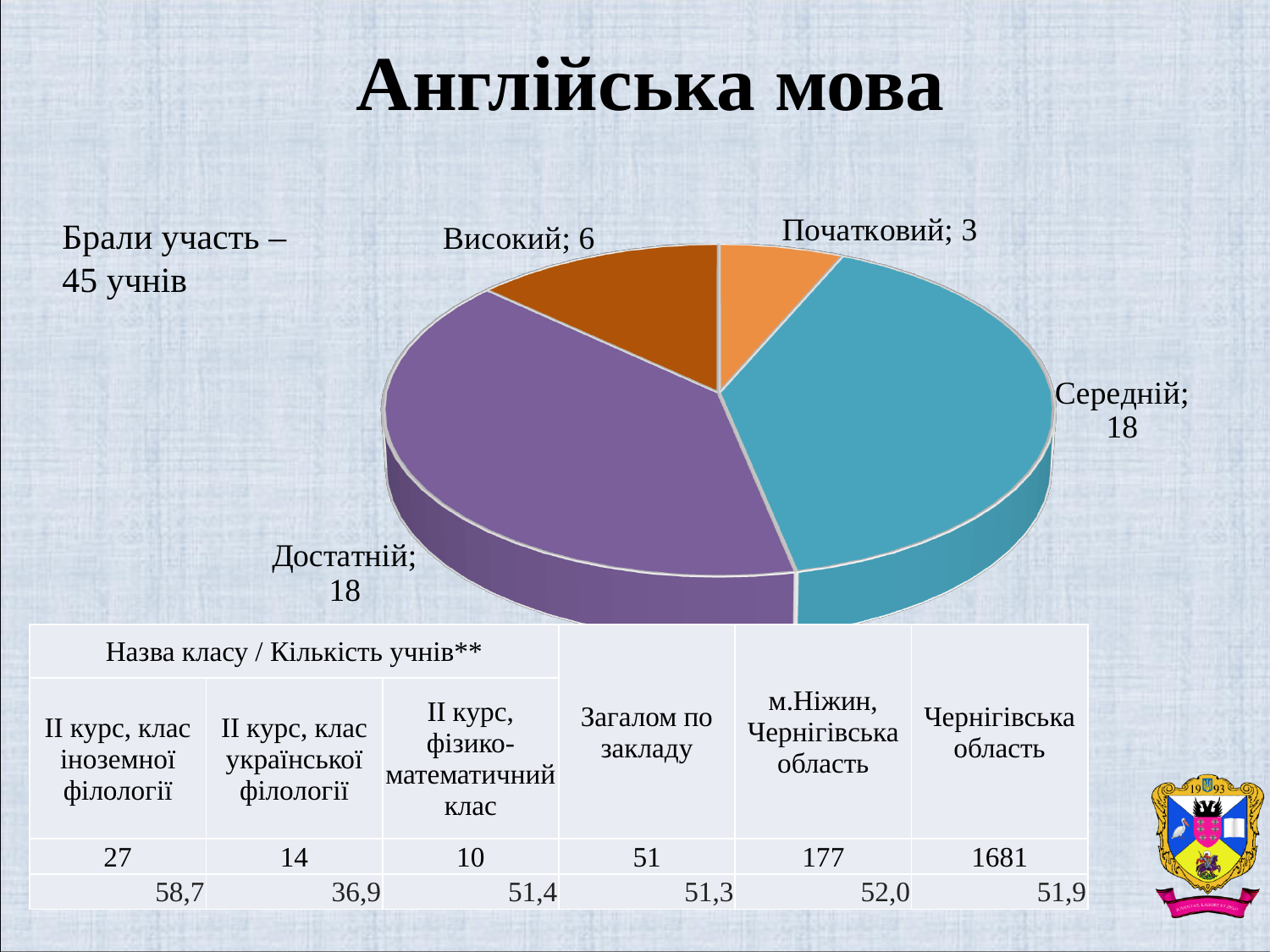
What is the total of all slices in the pie chart? 45 What share of the pie does the Середній slice represent? 40% What is the value for the Високий slice? 6 Which is larger, the value for Високий or the value for Початковий? Високий Which slice of the pie has the smallest value? Початковий What is the value for the Початковий slice? 3 What is the value for the Середній slice? 18 What is the difference between the values for Високий and Початковий? 3 What is the value for the Достатній slice? 18 What type of chart is shown on the slide? pie chart How many slices does the pie chart have? 4 What is the difference between the values for Середній and Високий? 12